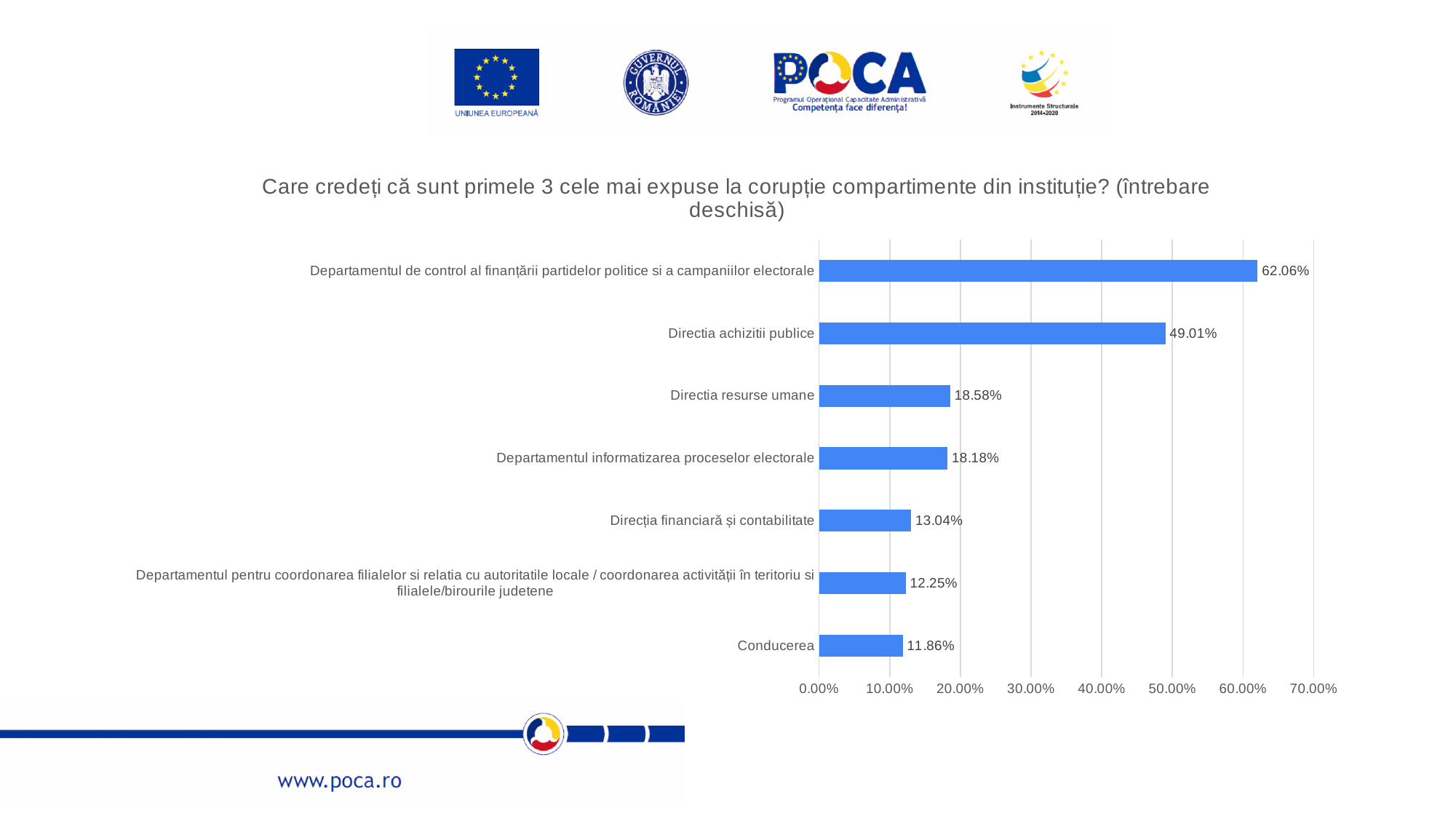
Which category has the lowest value? Conducerea What is the value for Conducerea? 11.86% Which is larger: the value for Directia resurse umane or the value for Departamentul informatizarea proceselor electorale? Directia resurse umane What is the value for Direcția financiară și contabilitate? 13.04% How many categories are shown in the chart? 7 What is the highest value shown on the x axis? 70.00% What is the difference between the values for Direcția financiară și contabilitate and Conducerea? 1.18% What is the value for Directia achizitii publice? 49.01% What is the difference between the values for Departamentul de control al finanțării partidelor politice si a campaniilor electorale and Directia achizitii publice? 13.05% Which category has the highest value? Departamentul de control al finanțării partidelor politice si a campaniilor electorale What kind of chart is shown on the slide? bar chart Is the value for Directia achizitii publice greater or less than 40.00%? greater